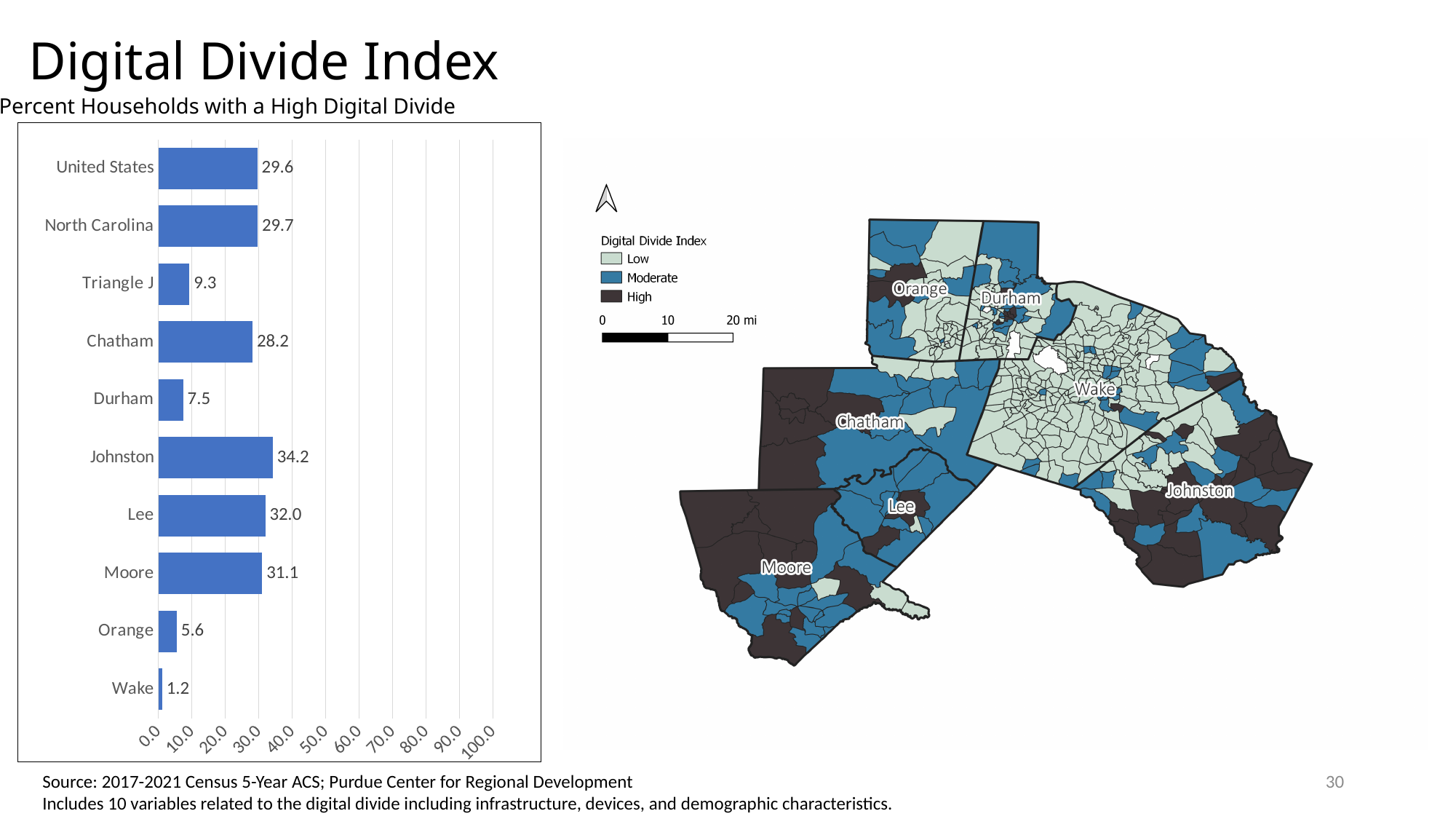
What is the difference between the values for Lee and Moore? 0.9 What is the value for Johnston in the bar chart? 34.2 Is the value for Moore greater or less than 30.0? greater What kind of chart is shown on the left of the slide? bar chart What is the value for Triangle J in the bar chart? 9.3 Which has a larger value, Chatham or Durham? Chatham Which category has the highest value in the bar chart? Johnston Which category has the lowest value in the bar chart? Wake What is the title of the bar chart? Percent Households with a High Digital Divide What is the difference between the values for North Carolina and the United States? 0.1 What is the value for Wake in the bar chart? 1.2 How many categories are shown in the bar chart? 10